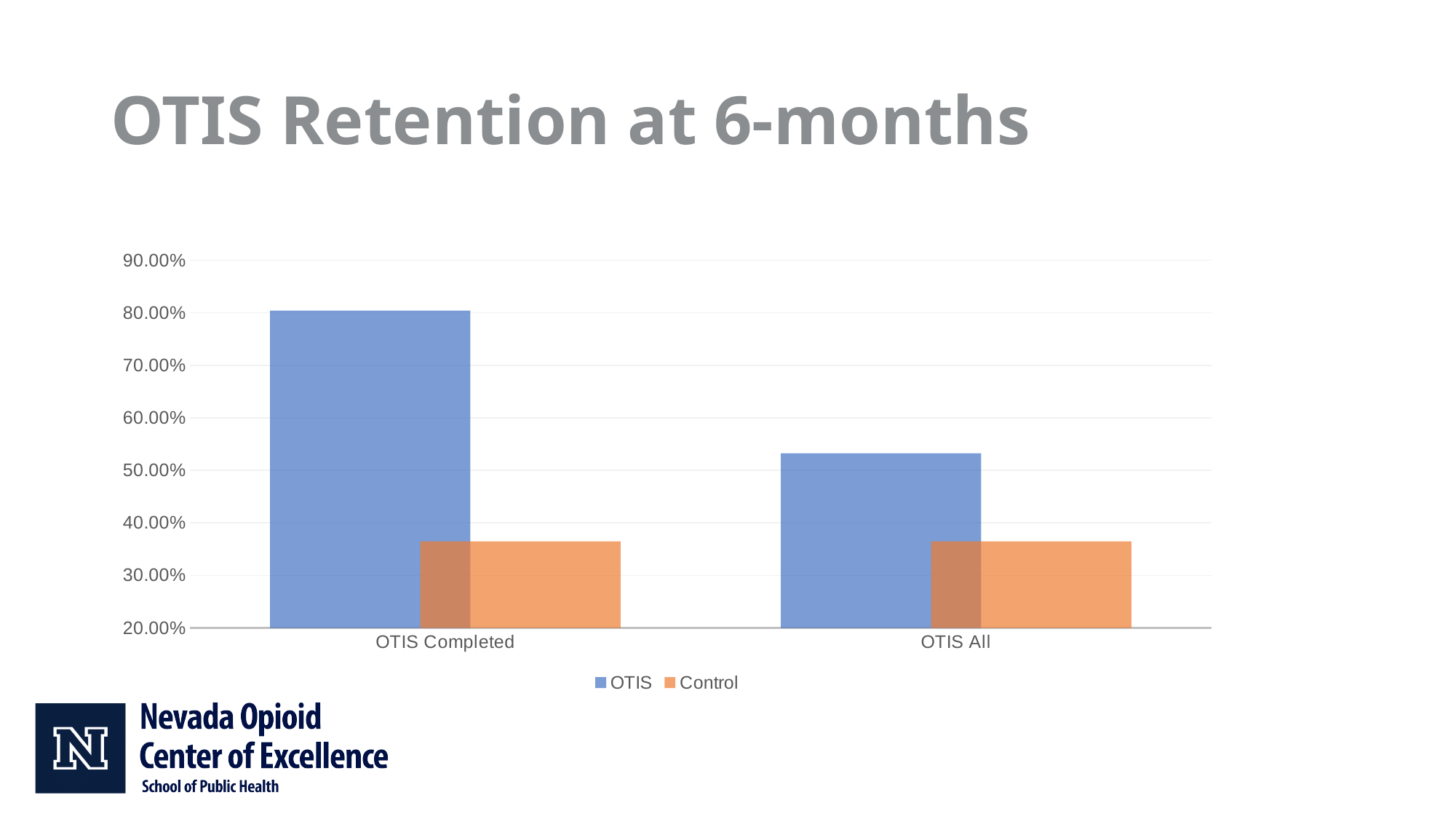
For OTIS All, which series has the larger value, OTIS or Control? OTIS Is the OTIS value for OTIS All greater or less than 50.00%? greater What kind of chart is shown on the slide? bar chart Is the Control value for OTIS All greater or less than 30.00%? greater Which category has the higher OTIS value, OTIS Completed or OTIS All? OTIS Completed Which series is shown in blue? OTIS How many categories are shown on the x axis? 2 What is the title of the slide's chart? OTIS Retention at 6-months Which bar is the tallest in the chart? OTIS for OTIS Completed Is the Control value for OTIS Completed greater or less than 40.00%? less How many series does the legend list? 2